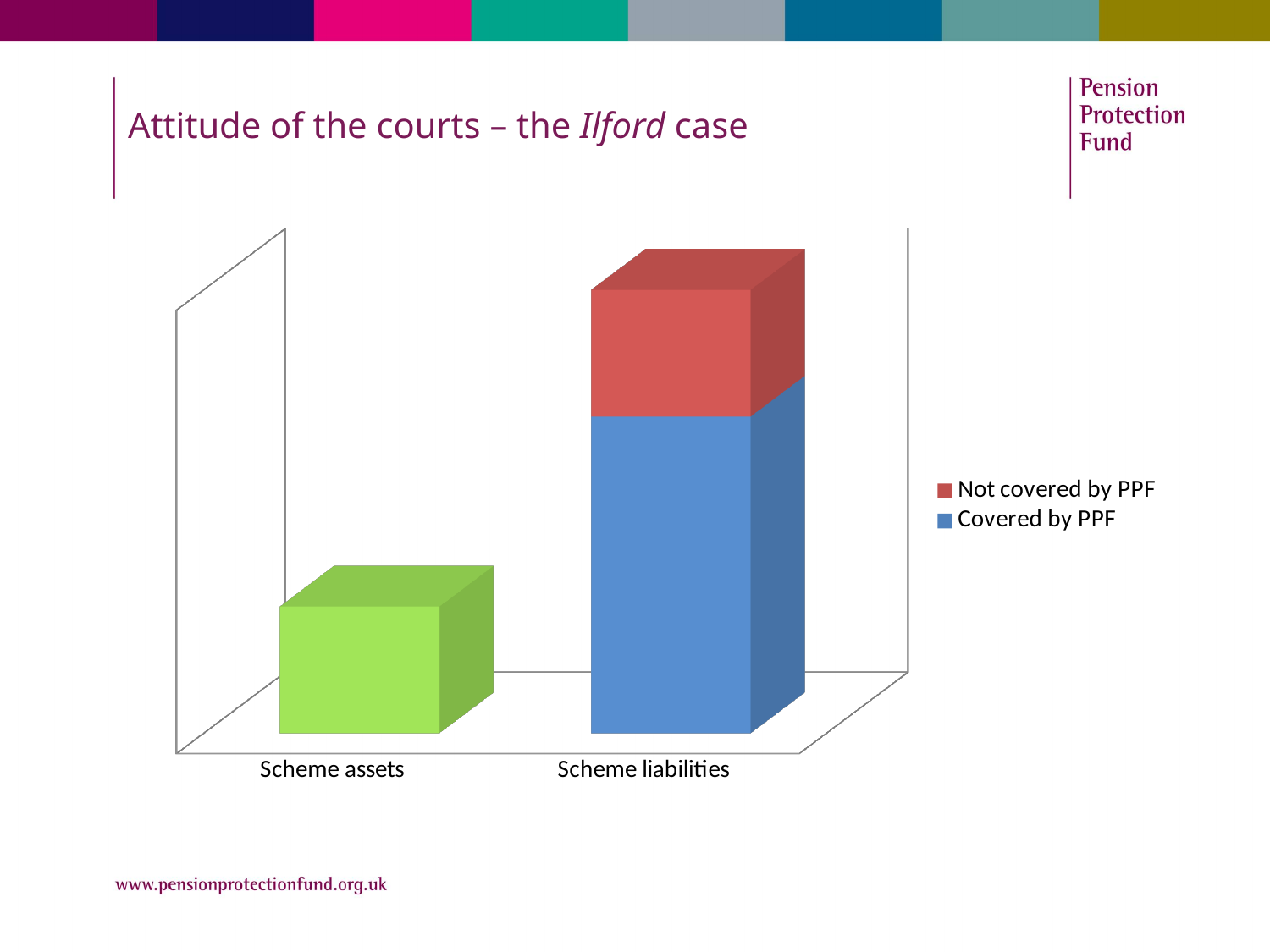
What kind of chart is shown on the slide? Bar chart Which category has the taller bar, Scheme assets or Scheme liabilities? Scheme liabilities What are the two category labels on the x axis of the chart? Scheme assets, Scheme liabilities How many categories are shown on the x axis of the chart? 2 How many series does the chart's legend list? 2 Within the Scheme liabilities bar, which segment is larger, Covered by PPF or Not covered by PPF? Covered by PPF Which category has the highest total bar in the chart? Scheme liabilities Which legend entry is shown in red in the chart? Not covered by PPF Which category has the lowest bar in the chart? Scheme assets